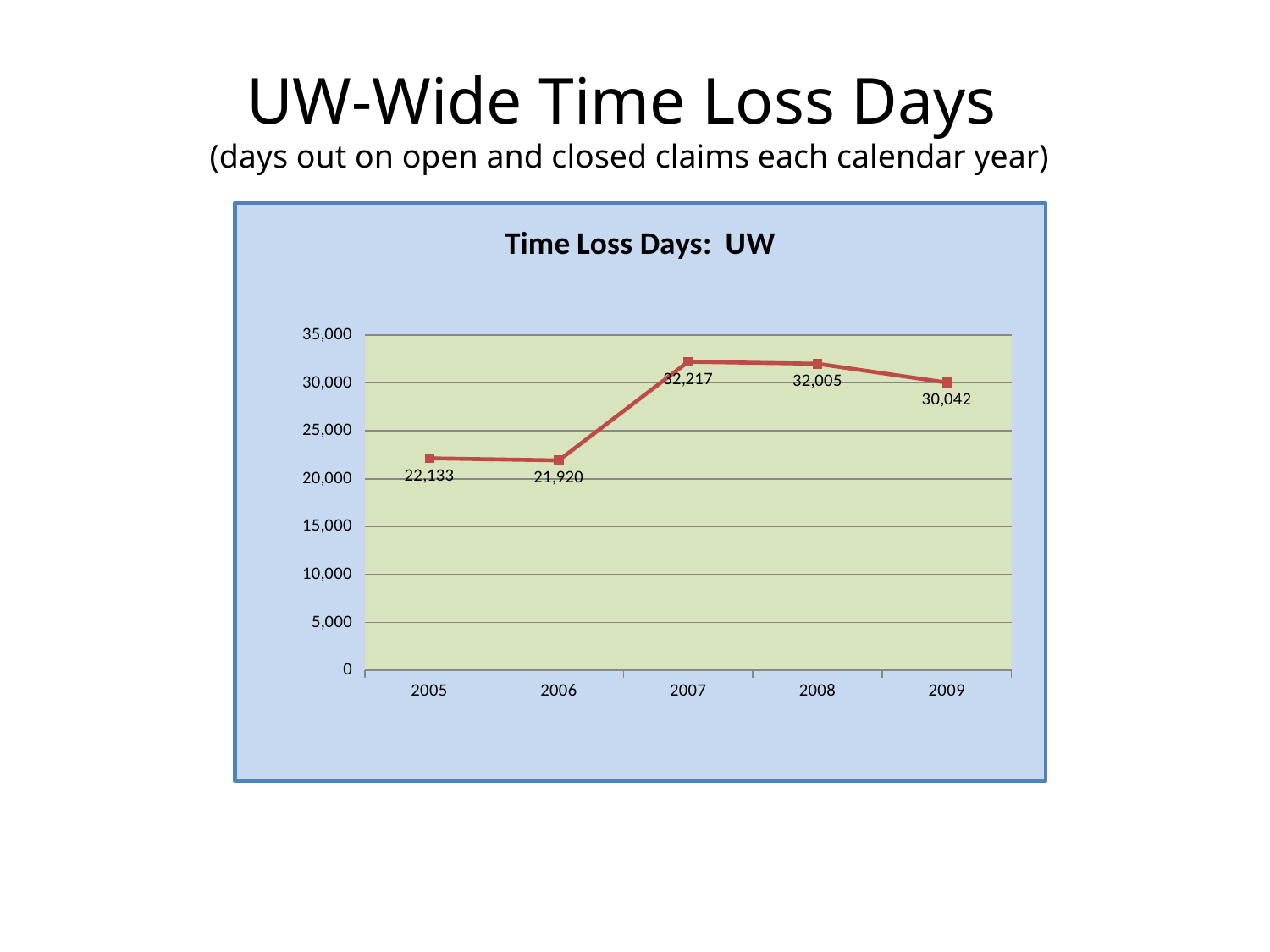
What is the difference between the values for 2007 and 2006? 10,297 What kind of chart is shown? line chart What is the title of the chart? Time Loss Days: UW What is the value for 2005? 22,133 What is the value for 2007? 32,217 Is the value for 2006 greater or less than 25,000? less How many years are plotted on the chart? 5 Which year has the lowest value? 2006 What is the difference between the values for 2008 and 2009? 1,963 Which is larger, the value for 2005 or the value for 2009? 2009 Which year has the highest value? 2007 What is the value for 2009? 30,042